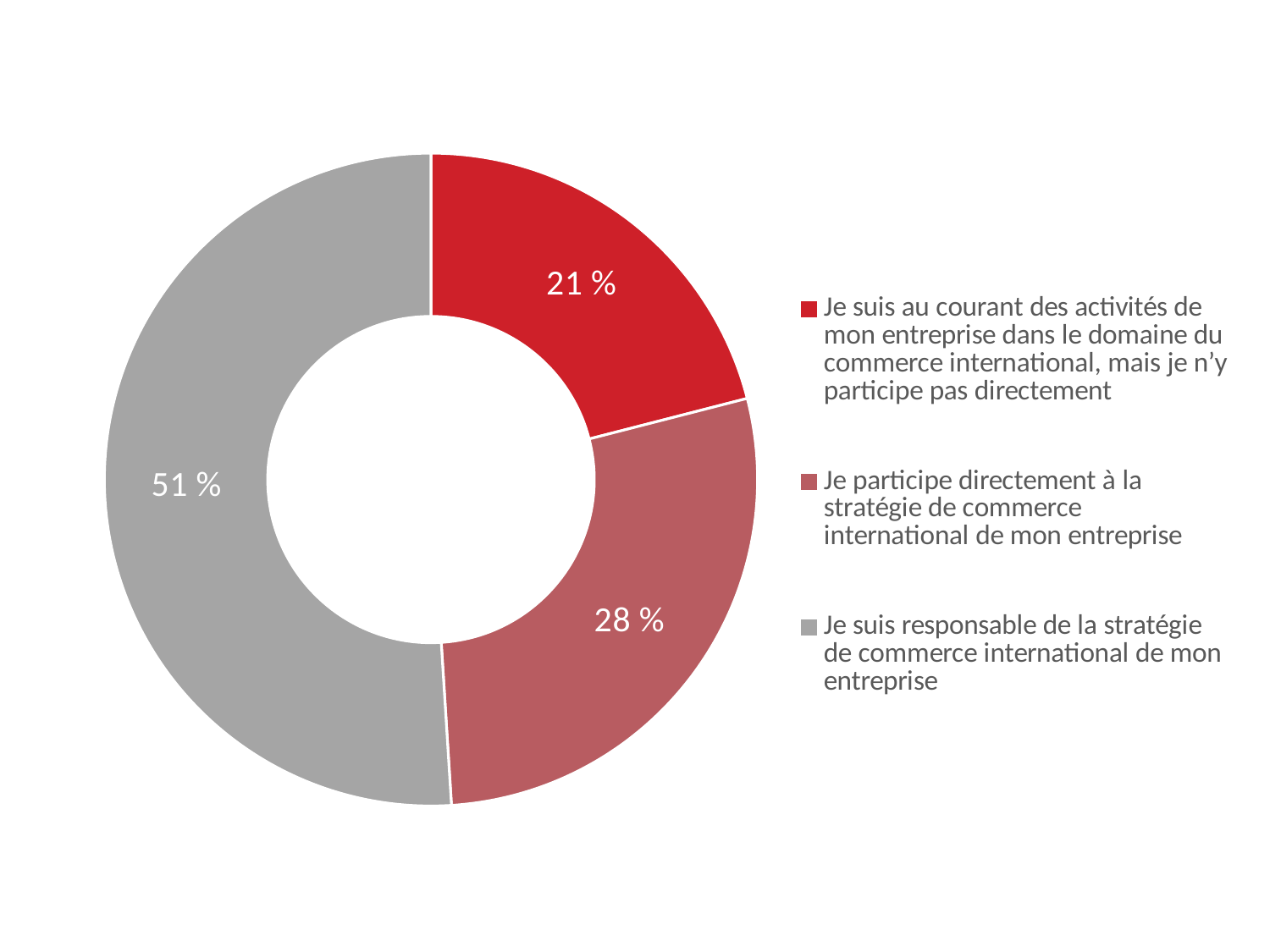
What share of respondents say they are aware of their company's international trade activities but do not participate directly? 21 % Which category has the largest share of the chart? Je suis responsable de la stratégie de commerce international de mon entreprise What share of respondents say they participate directly in their company's international trade strategy ("Je participe directement à la stratégie de commerce international de mon entreprise")? 28 % What is the combined share of the two red-toned slices (21 % and 28 %)? 49 % What kind of chart is shown on the slide? Doughnut (pie) chart What is the difference in percentage points between the largest slice (51 %) and the smallest slice (21 %)? 30 percentage points How many categories are shown in the chart? 3 What colour is the slice representing "Je suis responsable de la stratégie de commerce international de mon entreprise"? Grey Which is larger: the share for "Je participe directement à la stratégie de commerce international de mon entreprise" or the share for "Je suis au courant des activités... mais je n'y participe pas directement"? Je participe directement à la stratégie de commerce international de mon entreprise What share of respondents say they are responsible for their company's international trade strategy ("Je suis responsable de la stratégie de commerce international de mon entreprise")? 51 % What colour is the slice labelled 21 %? Red Which category has the smallest share of the chart? Je suis au courant des activités de mon entreprise dans le domaine du commerce international, mais je n'y participe pas directement